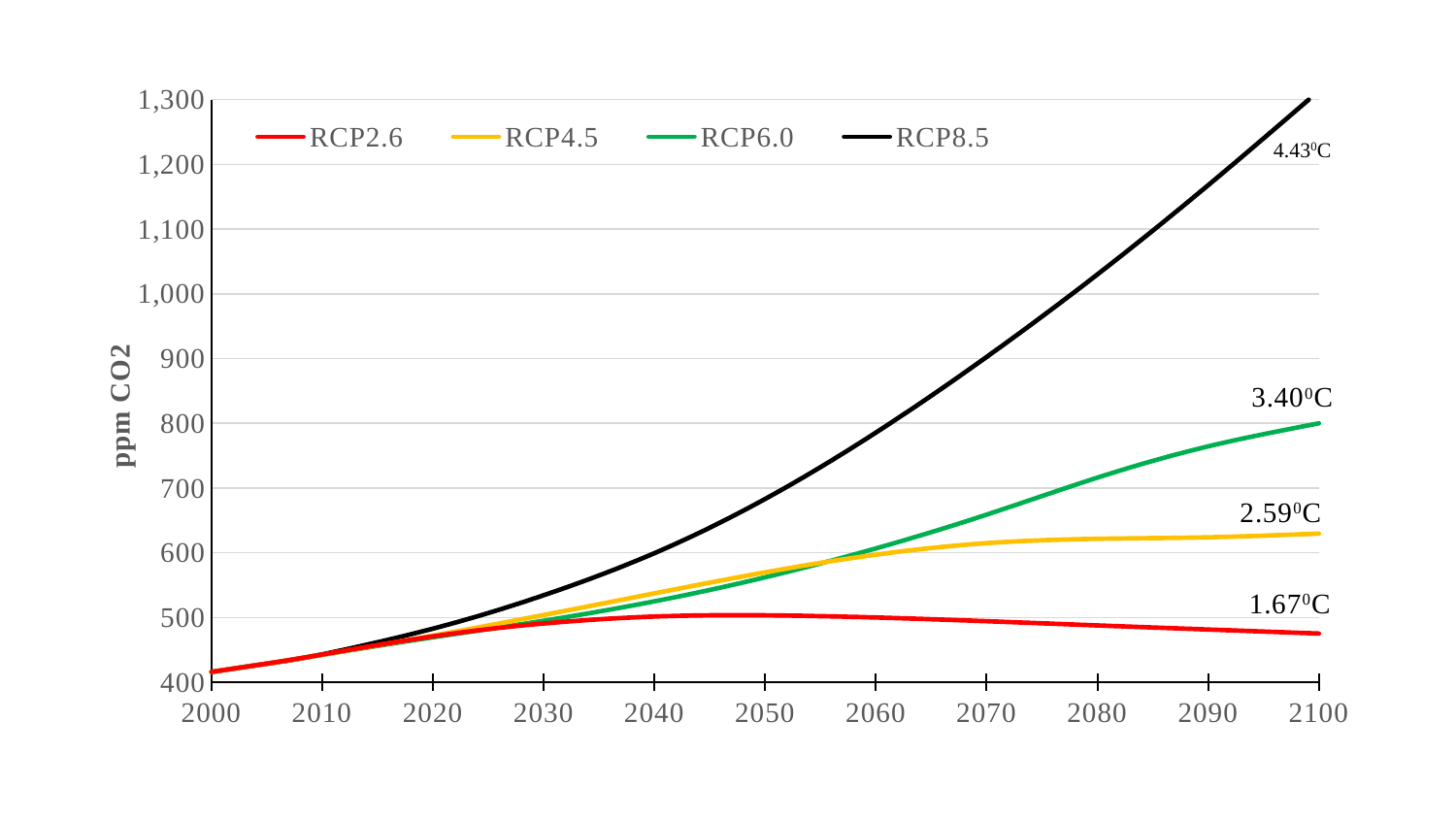
What type of chart is shown on the slide? line chart Which series has the highest ppm CO2 value in 2100? RCP8.5 Is the value for RCP8.5 in 2050 greater or less than 600? greater Is the value for RCP4.5 in 2100 greater or less than 700? less Does the RCP8.5 line rise or fall from 2000 to 2100? rise Is the value for RCP2.6 in 2100 greater or less than 500? less Which series has the lowest ppm CO2 value in 2100? RCP2.6 How many series does the legend list? 4 What is the ppm CO2 value of RCP6.0 in 2100? 800 In 2100, which is larger, RCP6.0 or RCP4.5? RCP6.0 What temperature label is shown next to the end of the RCP8.5 line? 4.43⁰C